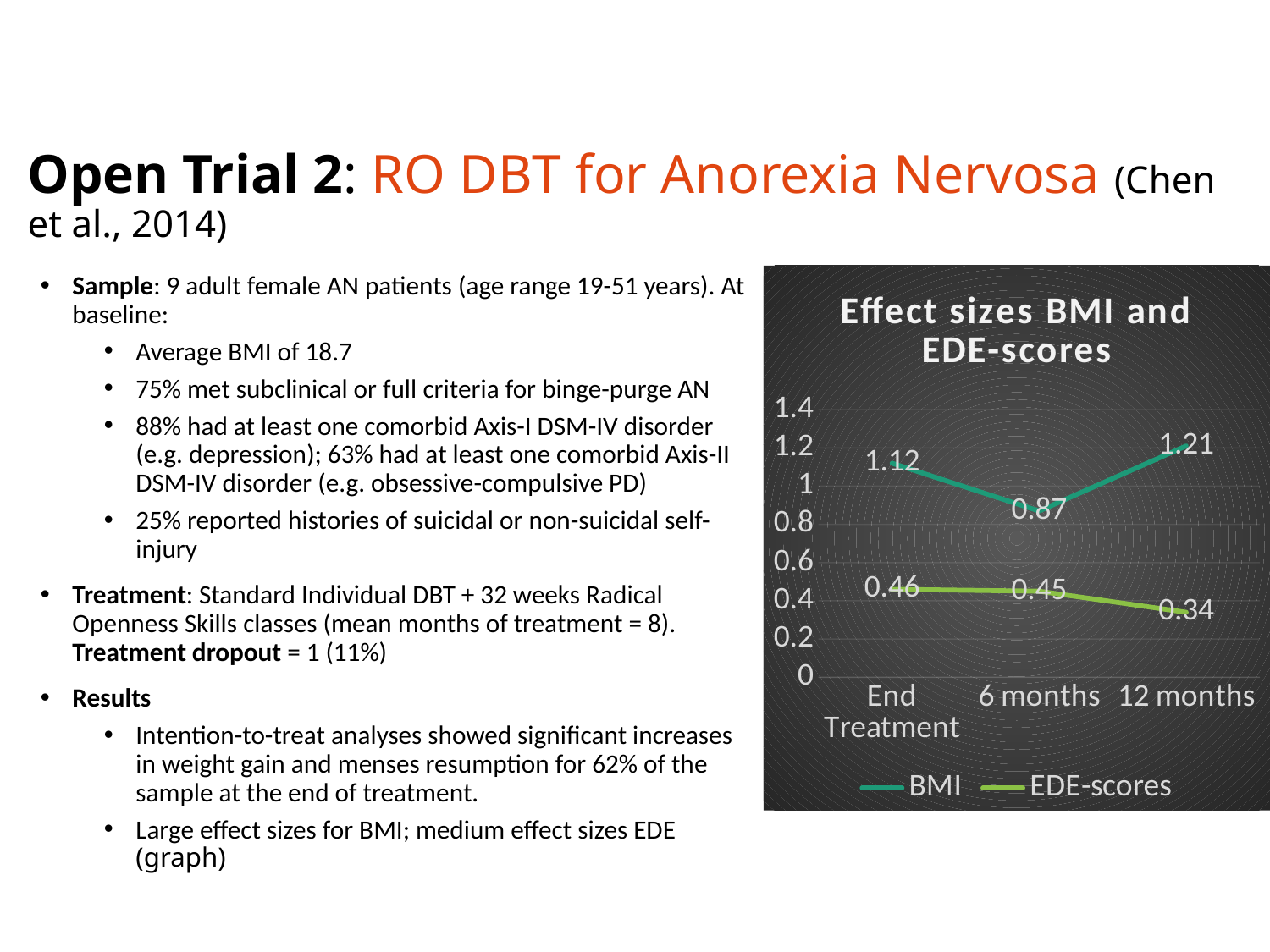
At which time point is the BMI effect size highest? 12 months How many time points are shown on the x axis? 3 How many series does the legend list? 2 At which time point is the EDE-scores effect size lowest? 12 months What is the EDE-scores effect size at 12 months? 0.34 Which is larger at 6 months, the BMI effect size or the EDE-scores effect size? BMI Is the BMI effect size at 12 months greater or less than 1? greater Do the EDE-scores effect sizes rise or fall from End Treatment to 12 months? fall What is the difference between the BMI effect size at 12 months and at 6 months? 0.34 What is the BMI effect size at End Treatment? 1.12 What is the BMI effect size at 6 months? 0.87 What kind of chart is shown on the slide? line chart